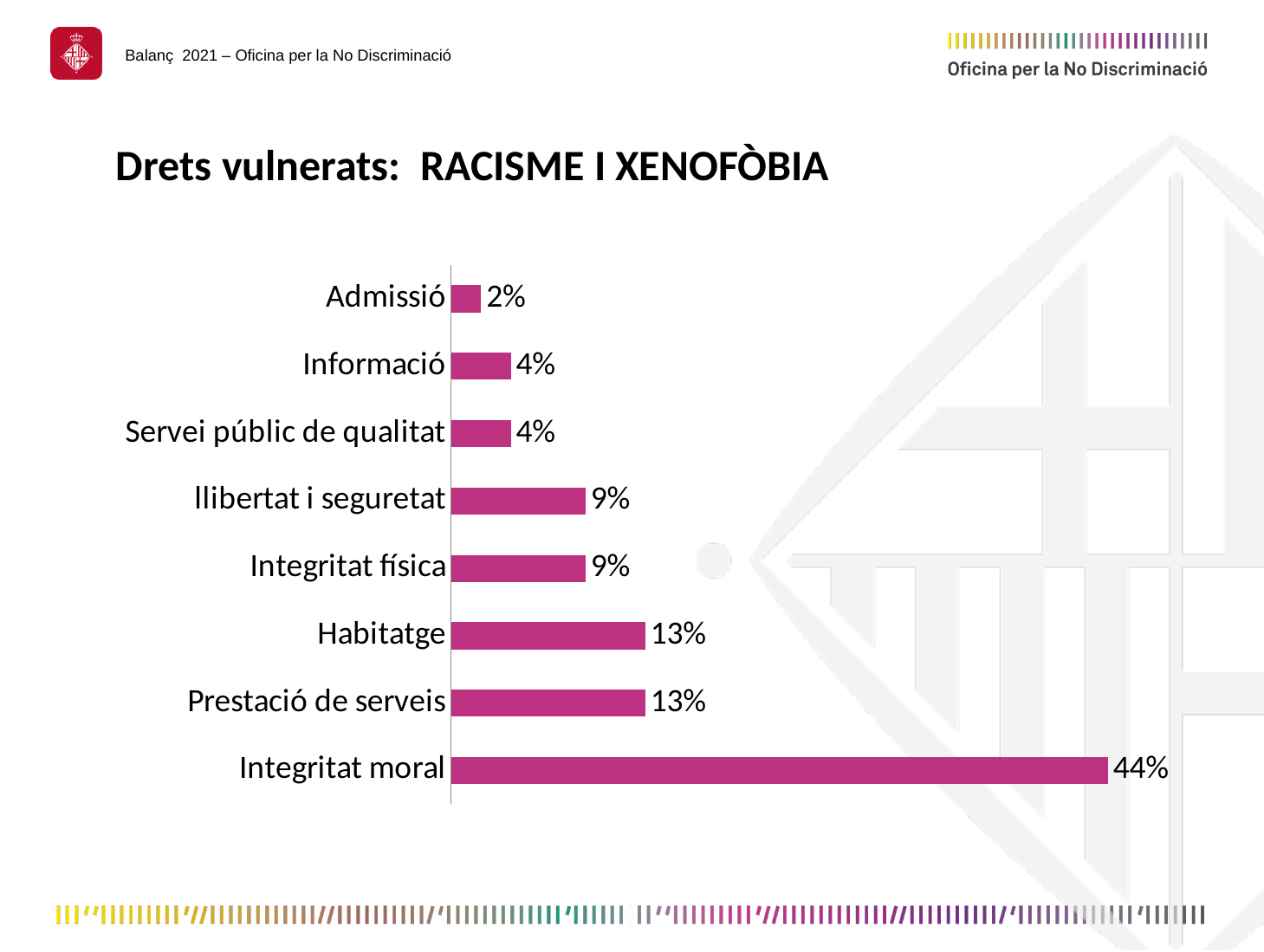
What is the value for Servei públic de qualitat? 4% Which category has the lowest value? Admissió What is the value for Integritat moral? 44% Which category has the highest value? Integritat moral What is the difference between the values for Habitatge and Informació? 9% What is the value for Admissió? 2% Which is larger, the value for llibertat i seguretat or the value for Admissió? llibertat i seguretat How many categories are shown in the chart? 8 What is the title of the slide containing the chart? Drets vulnerats: RACISME I XENOFÒBIA What is the difference between the values for Integritat moral and Prestació de serveis? 31% What kind of chart is shown on the slide? Bar chart What is the value for Habitatge? 13%